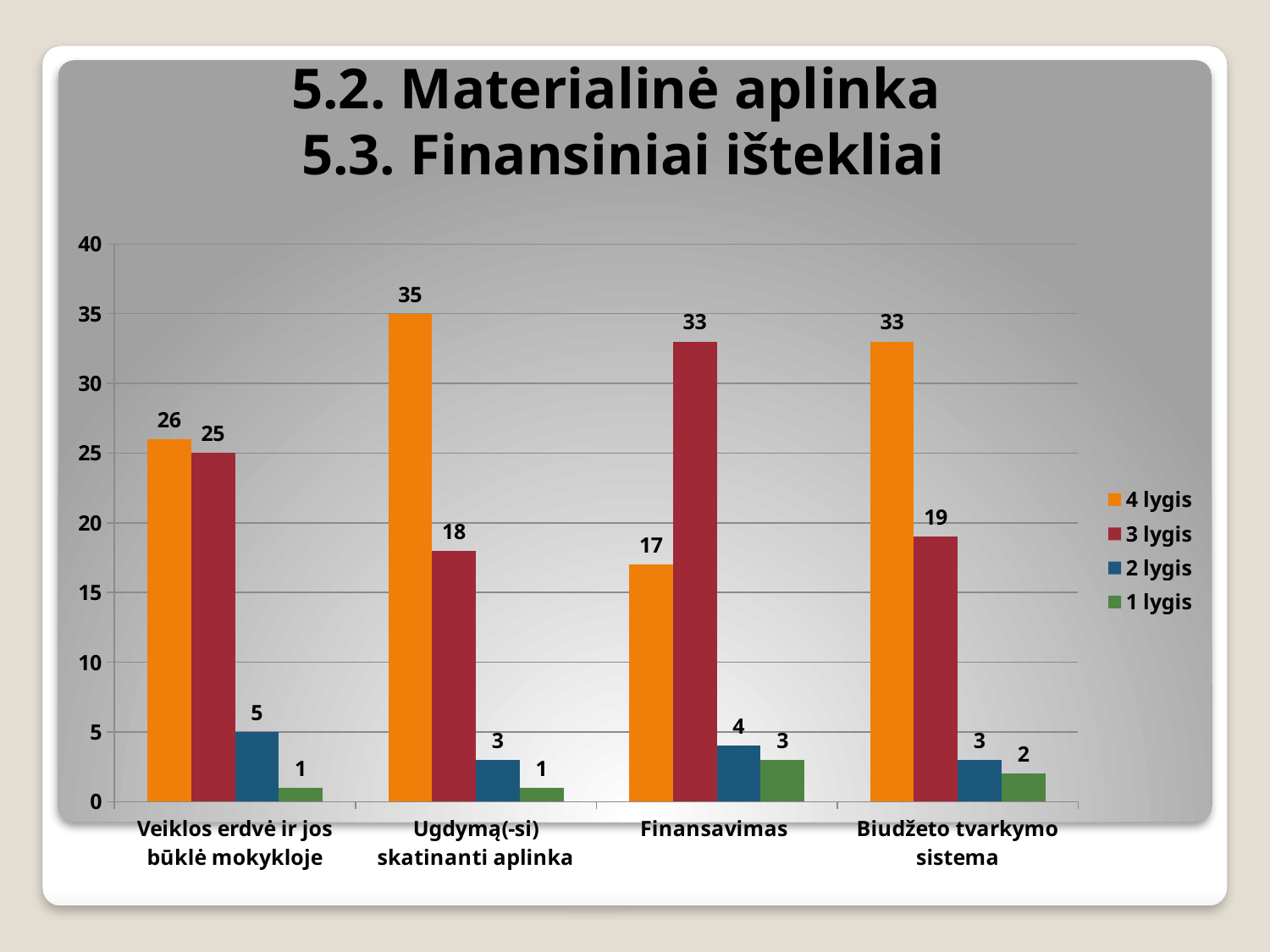
What colour represents the 3 lygis series in the legend? red What is the value of the 3 lygis series for Finansavimas? 33 Which category has the lowest 4 lygis value? Finansavimas What is the value of the 1 lygis series for Biudžeto tvarkymo sistema? 2 How many series does the legend list? 4 For Finansavimas, which is larger: the 4 lygis value or the 3 lygis value? 3 lygis How many categories are shown on the x axis? 4 Which category has the highest 4 lygis value? Ugdymą(-si) skatinanti aplinka What is the difference between the 4 lygis and 3 lygis values for Biudžeto tvarkymo sistema? 14 What is the value of the 2 lygis series for Veiklos erdvė ir jos būklė mokykloje? 5 What kind of chart is shown on the slide? bar chart What is the value of the 4 lygis series for Ugdymą(-si) skatinanti aplinka? 35